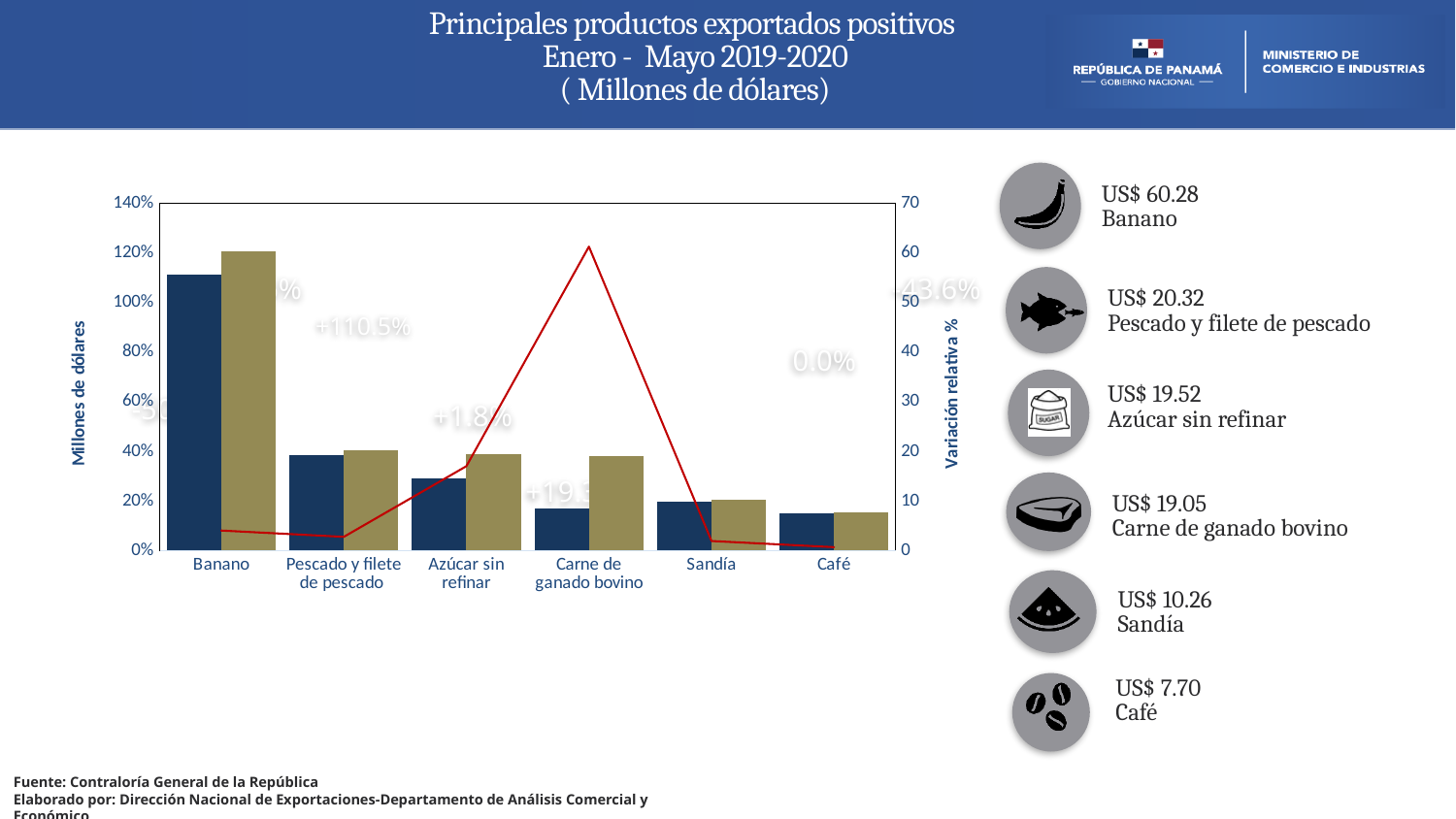
What kind of chart is shown on the slide? A bar chart combined with a line Is the red line value for Carne de ganado bovino greater or less than 50 on the right axis? greater According to the panel on the right of the chart, what is the export value for Azúcar sin refinar? US$ 19.52 Which product has the tallest bars in the chart? Banano How many product categories are shown on the x axis of the chart? 6 Is the dark blue bar for Banano greater or less than 100% on the left axis? greater Do the bar heights generally rise or fall moving from Banano to Café along the x axis? Fall Are the bars for Café greater or less than 20% on the left axis? less Which product has the highest point on the red line (Variación relativa %)? Carne de ganado bovino What is the title of the right-hand vertical axis of the chart? Variación relativa % Are the bars for Banano taller or shorter than the bars for Sandía? Taller Which product has the shortest bars in the chart? Café